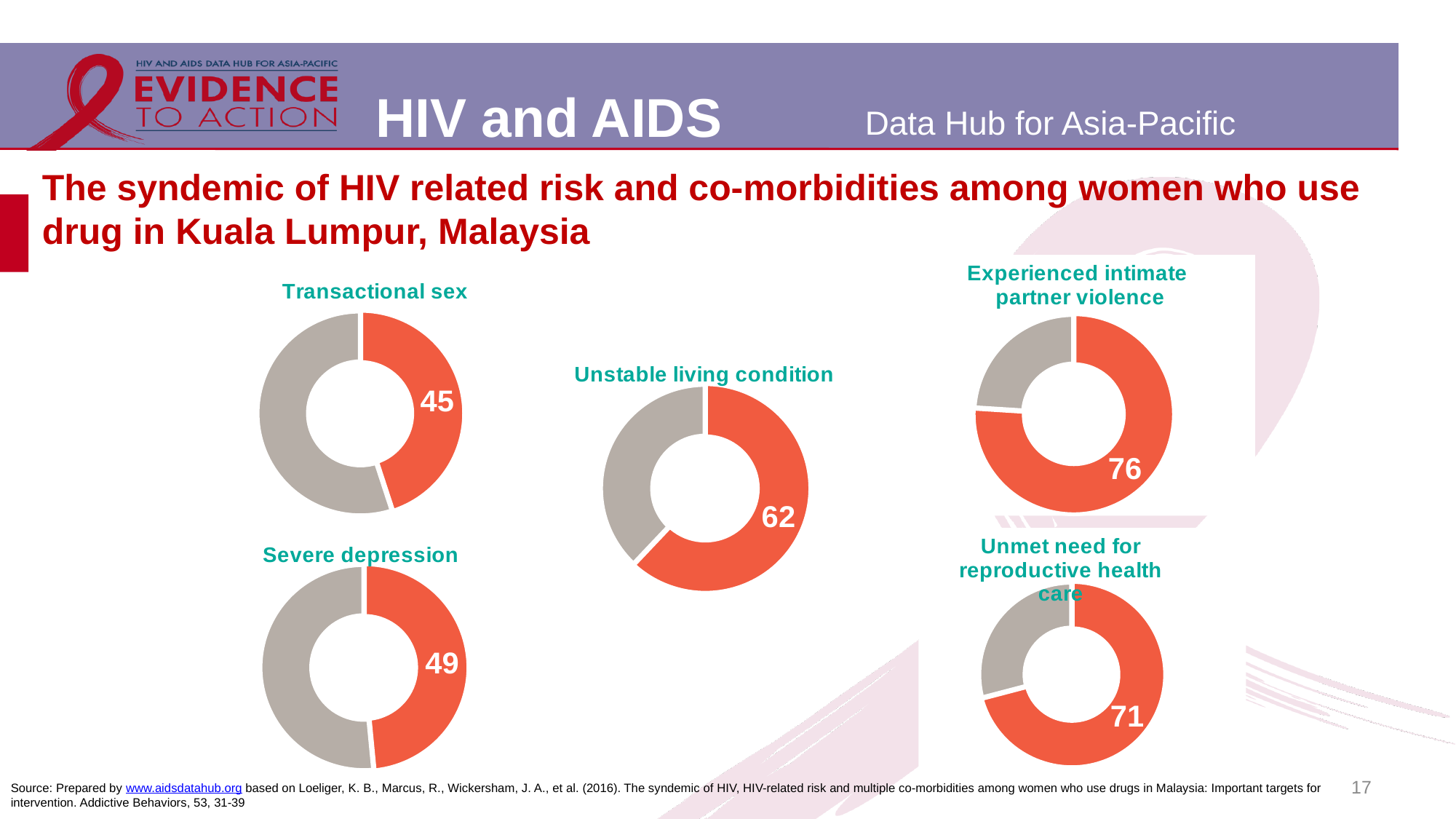
What is the difference between the value in the 'Experienced intimate partner violence' chart and the value in the 'Transactional sex' chart? 31 What is the difference between the values in the 'Unmet need for reproductive health care' chart and the 'Unstable living condition' chart? 9 What type of chart is used for 'Severe depression' on the slide? Donut (pie) chart In the 'Severe depression' donut chart, what value is printed on the orange segment? 49 How many donut charts are shown on the slide? 5 Across the five donut charts on the slide, which indicator has the highest printed value? Experienced intimate partner violence In the 'Experienced intimate partner violence' donut chart, what value is shown? 76 Which is larger: the value in the 'Unstable living condition' chart or the value in the 'Severe depression' chart? Unstable living condition In the 'Unstable living condition' donut chart, what value is printed on the orange segment? 62 Across the five donut charts on the slide, which indicator has the lowest printed value? Transactional sex In the 'Transactional sex' donut chart, what value is shown for the highlighted (orange) segment? 45 In the 'Unmet need for reproductive health care' donut chart, what value is shown? 71